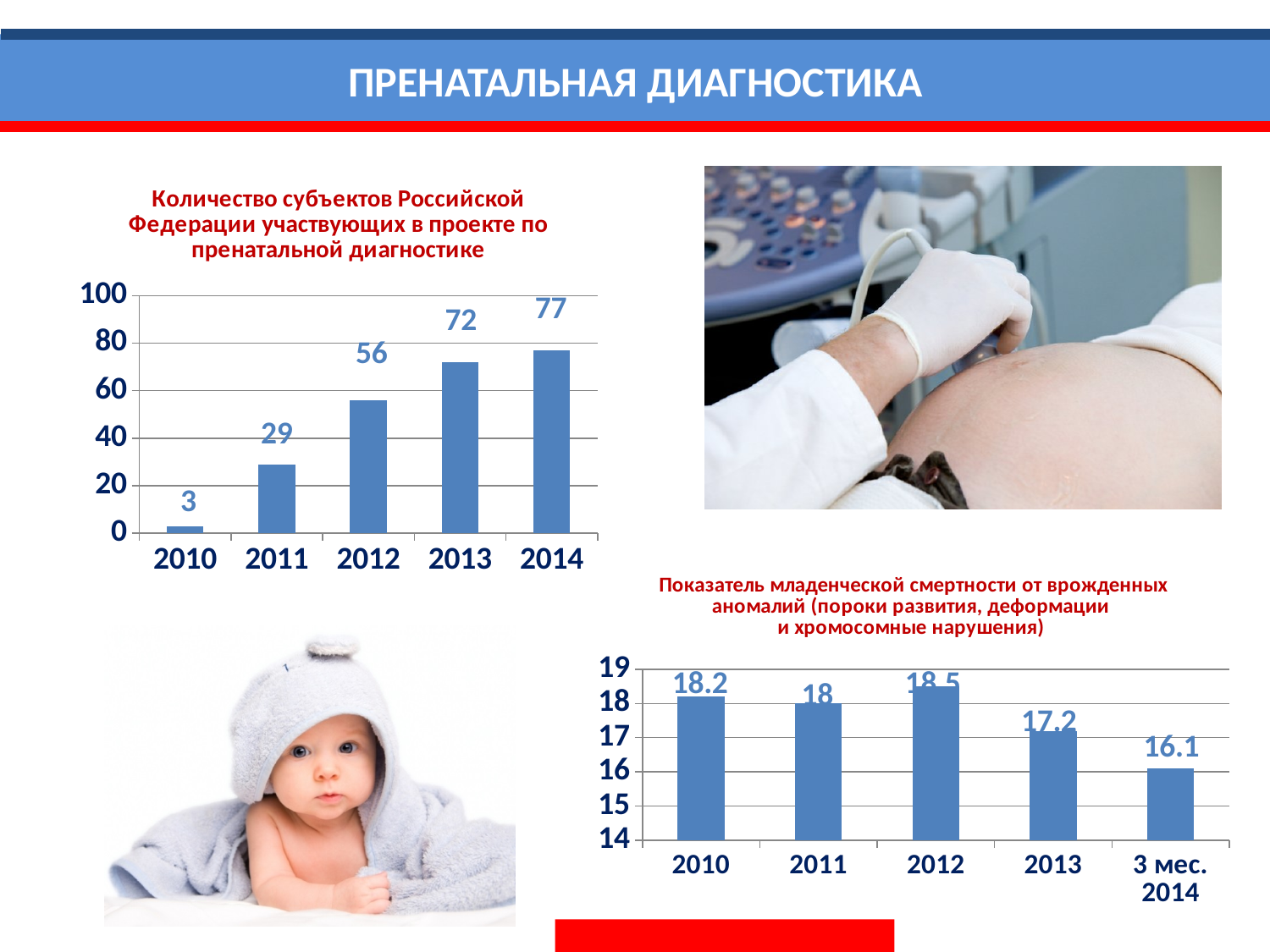
In the top-left chart (number of subjects participating in the project), do the values rise or fall from 2010 to 2014? rise In the bottom-right chart (infant mortality rate from congenital anomalies), what is the value for 3 мес. 2014? 16.1 In the top-left chart (number of subjects participating in the project), what is the difference between the values for 2014 and 2010? 74 How many years are shown on the x axis of the top-left chart (number of subjects participating in the project)? 5 In the top-left chart (number of subjects participating in the project), which year has the highest value? 2014 What kind of chart is the bottom-right chart (infant mortality rate from congenital anomalies)? bar chart In the top-left chart (number of subjects of the Russian Federation participating in the prenatal diagnostics project), what is the value for 2012? 56 In the bottom-right chart (infant mortality rate from congenital anomalies), what is the difference between the values for 2012 and 3 мес. 2014? 2.4 In the bottom-right chart (infant mortality rate from congenital anomalies), what is the value for 2013? 17.2 In the top-left chart (number of subjects participating in the project), which year has the lowest value? 2010 In the bottom-right chart (infant mortality rate from congenital anomalies), which is larger, the value for 2010 or the value for 2011? 2010 In the bottom-right chart (infant mortality rate from congenital anomalies), which category has the highest value? 2012